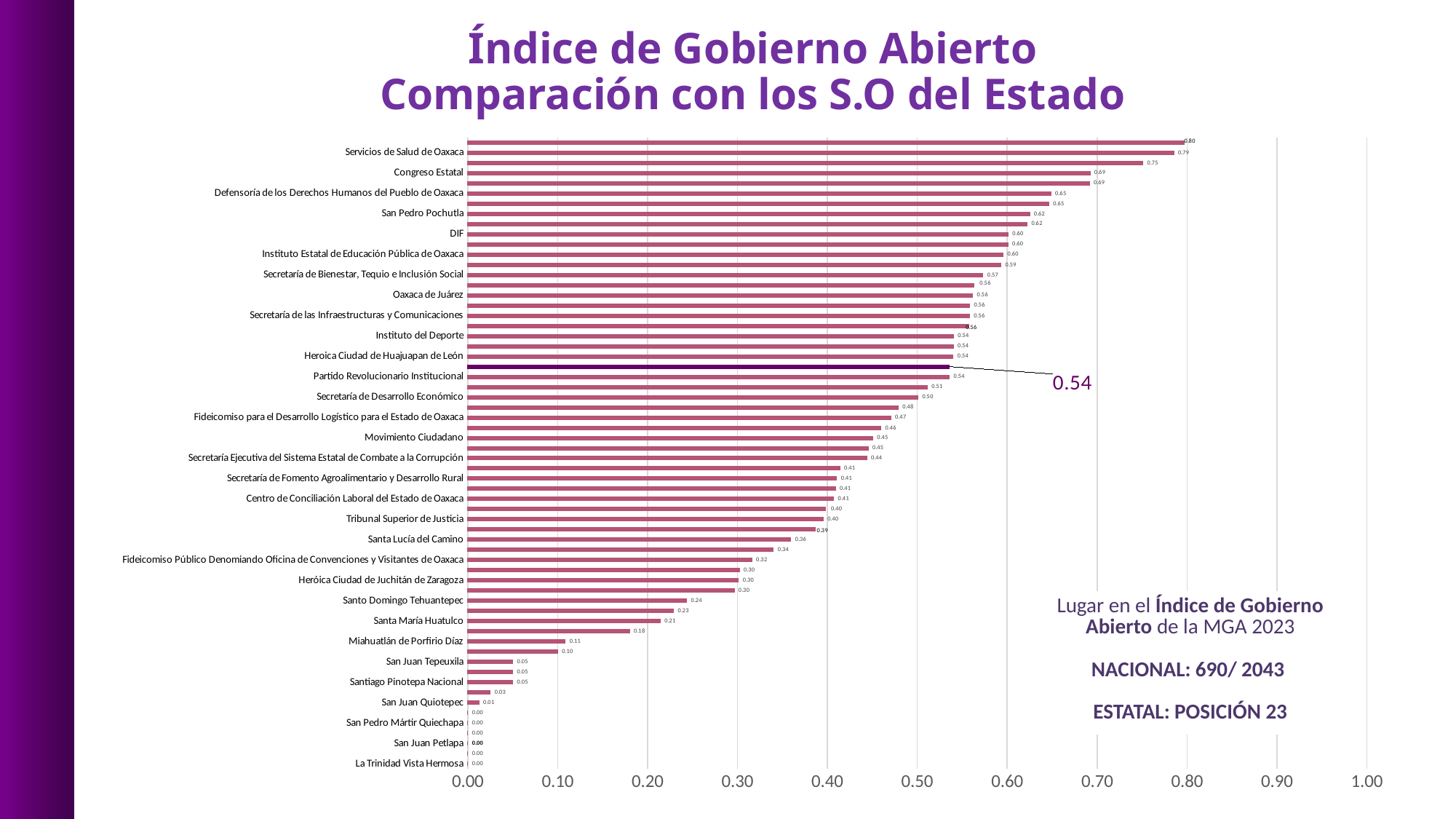
Is the value for Santo Domingo Tehuantepec greater or less than 0.40? less What is the value for Instituto Estatal de Educación Pública de Oaxaca? 0.60 What is the value for Oaxaca de Juárez? 0.56 Which has a larger value, Servicios de Salud de Oaxaca or Santa María Huatulco? Servicios de Salud de Oaxaca What value does the callout next to the highlighted dark purple bar show? 0.54 According to the text on the slide, what is the national position in the Índice de Gobierno Abierto de la MGA 2023? 690/ 2043 Is the value for Servicios de Salud de Oaxaca greater or less than 0.70? greater What is the value for Partido Revolucionario Institucional? 0.54 What kind of chart is shown on the slide? bar chart What is the value for La Trinidad Vista Hermosa? 0.00 What is the highest value shown on the horizontal axis? 1.00 What is the value for Centro de Conciliación Laboral del Estado de Oaxaca? 0.41